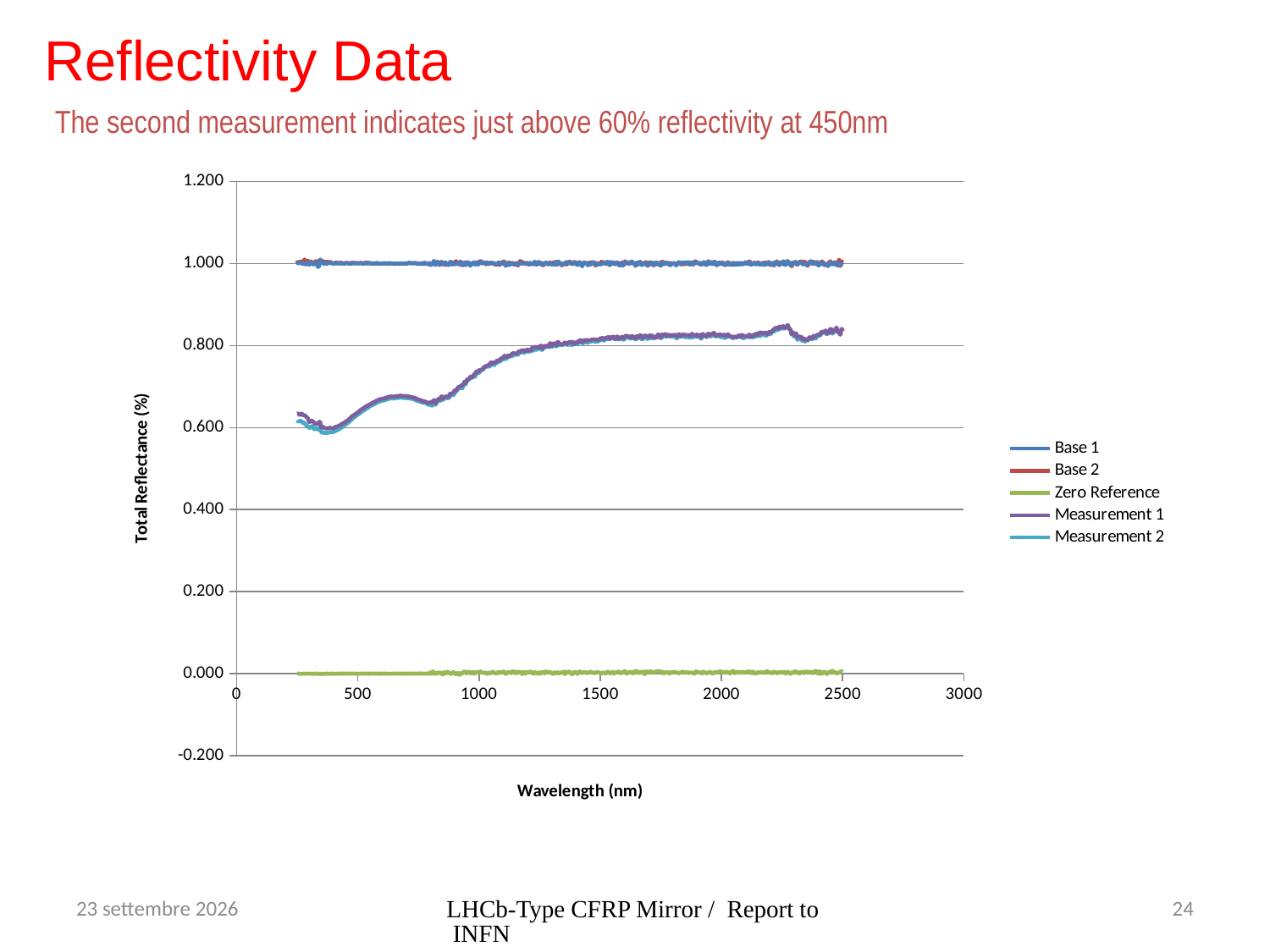
What kind of chart is shown on the slide? line chart Is the value of Measurement 1 at 500 nm greater or less than 0.800? less Does Measurement 1 rise or fall between 500 nm and 2000 nm? rise At 1000 nm, which is larger: Zero Reference or Measurement 2? Measurement 2 How many series does the legend list? 5 At 1500 nm, which is larger: Base 1 or Measurement 1? Base 1 Is the value of Base 1 at 1500 nm greater or less than 0.800? greater What is the title of the x axis? Wavelength (nm) What is the title of the y axis? Total Reflectance (%) Is the value of Zero Reference at 1500 nm greater or less than 0.200? less